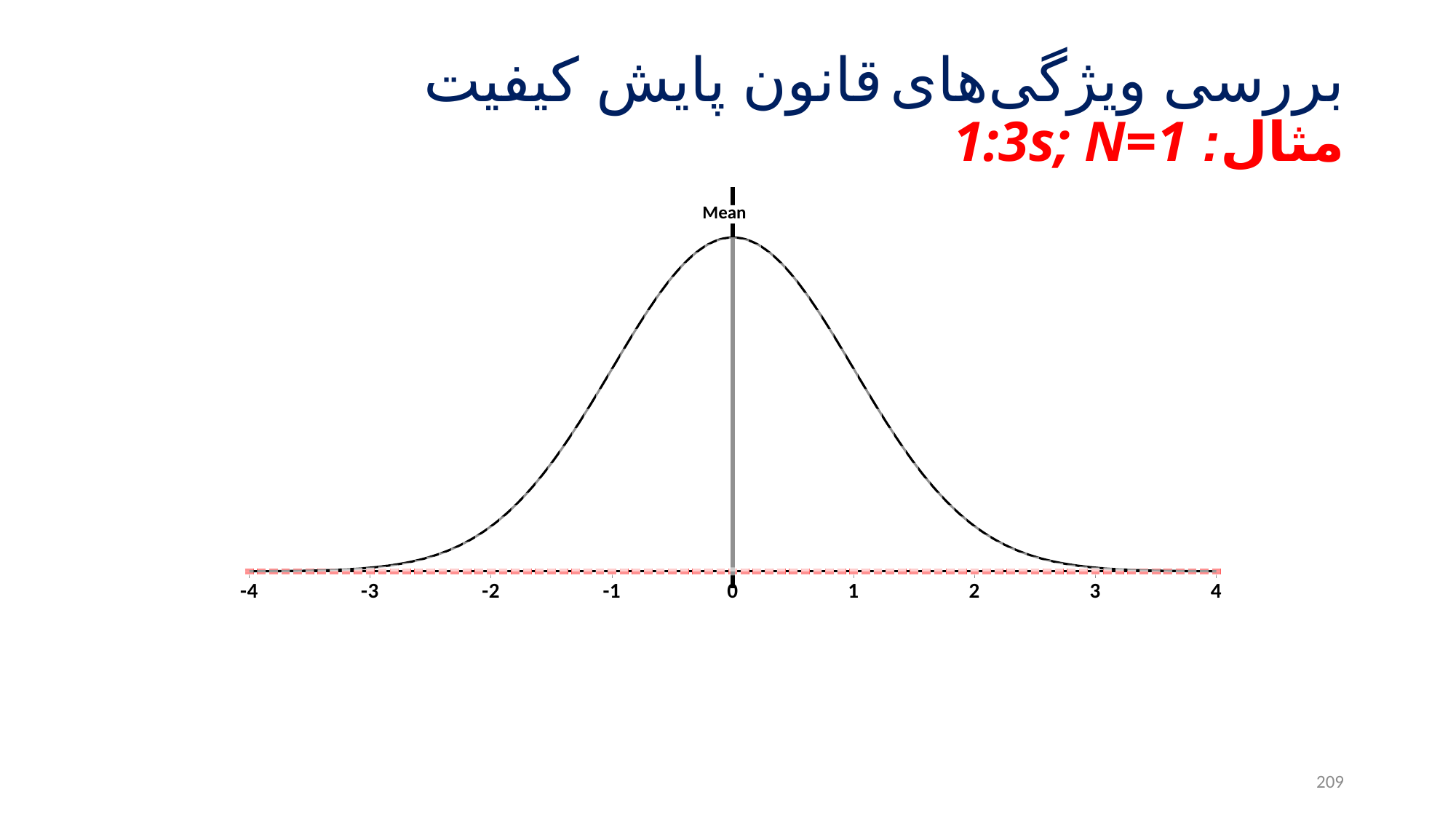
Does the curve rise or fall as x goes from 0 to 4? fall What is the label on the vertical line at the centre of the chart? Mean How many tick labels are shown on the x axis? 9 What is the highest value shown on the x axis? 4 Does the curve rise or fall as x goes from -4 to 0? rise What kind of chart is shown on the slide? line chart At which x-axis value does the curve reach its highest point? 0 Is the curve higher at x = 1 or at x = 2? 1 Is the curve higher at x = 0 or at x = 3? 0 What is the lowest value shown on the x axis? -4 Is the curve higher at x = -1 or at x = -3? -1